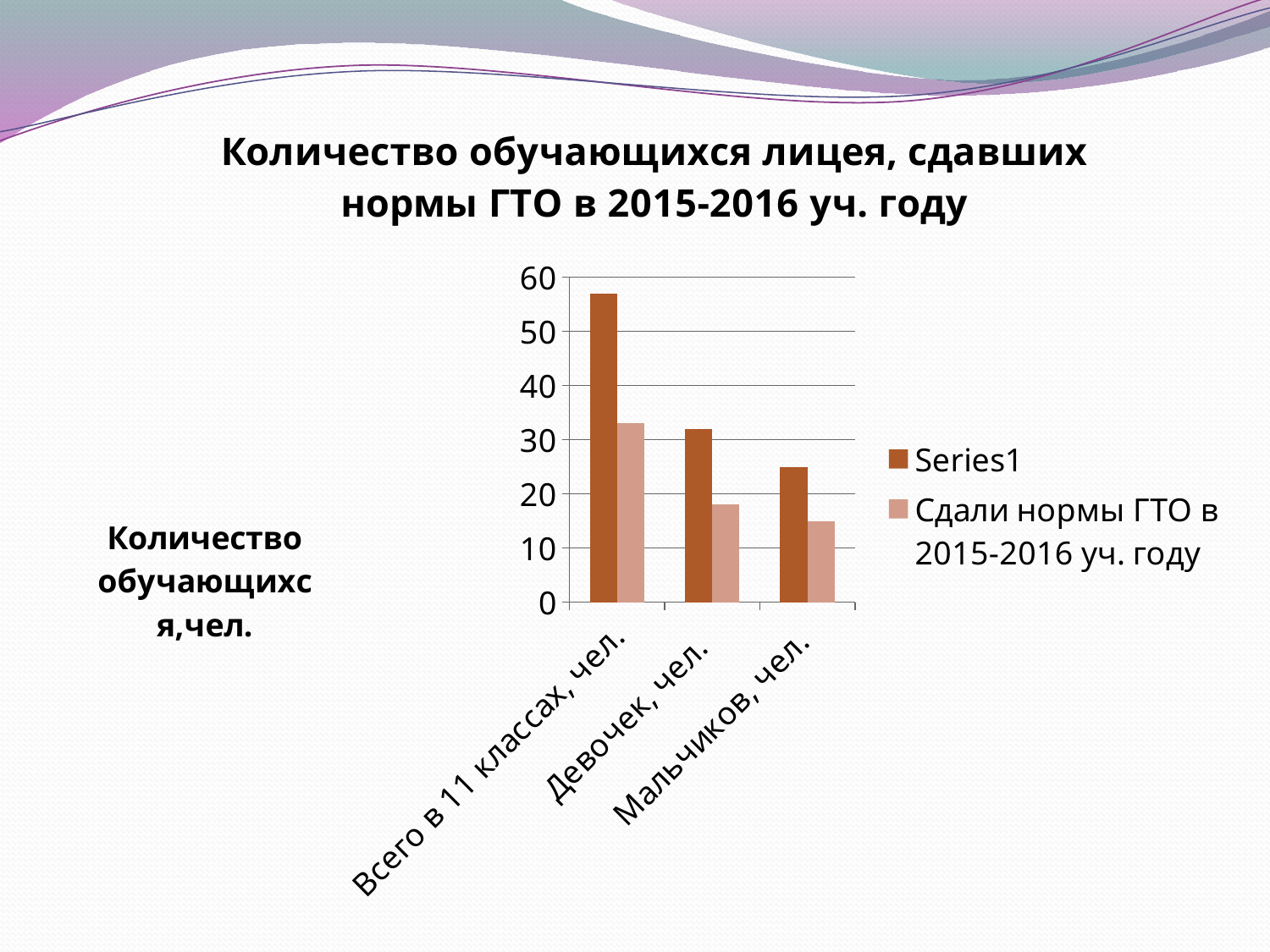
What is the title of the chart on the slide? Количество обучающихся лицея, сдавших нормы ГТО в 2015-2016 уч. году How many categories are shown on the x axis of the chart? 3 Is the Series1 value for 'Всего в 11 классах, чел.' greater or less than 50? greater Which is larger: the Series1 value for 'Девочек, чел.' or the Series1 value for 'Мальчиков, чел.'? Девочек, чел. Which category has the highest Series1 value? Всего в 11 классах, чел. How many series does the chart legend list? 2 Which category has the lowest value for 'Сдали нормы ГТО в 2015-2016 уч. году'? Мальчиков, чел. What kind of chart is shown on the slide? bar chart Is the value of 'Сдали нормы ГТО в 2015-2016 уч. году' for 'Девочек, чел.' greater or less than 20? less Do the Series1 values rise or fall from left to right along the x axis? fall Is the Series1 value for 'Мальчиков, чел.' greater or less than 30? less